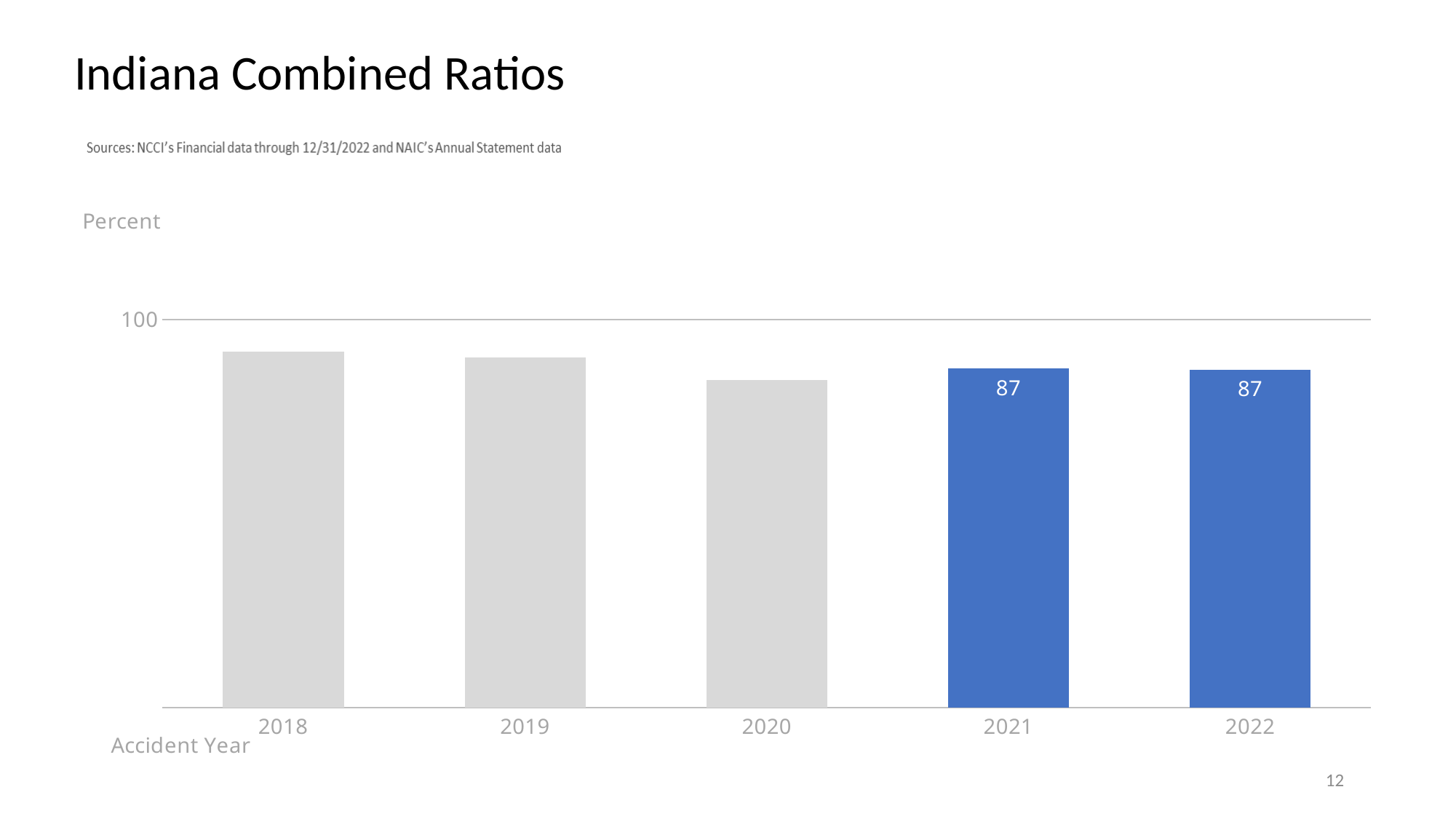
What is the combined ratio for accident year 2021? 87 What is the difference between the values for 2021 and 2022? 0 Which accident year has the lowest combined ratio? 2020 What kind of chart is shown on the slide? Bar chart Which is larger, the value for 2018 or the value for 2020? 2018 Are the values for 2021 and 2022 the same? Yes Do the values rise or fall from 2018 to 2020? Fall What is the label of the horizontal axis? Accident Year Is the value for 2020 greater or less than 100? less How many accident years are shown in the chart? 5 What is the combined ratio for accident year 2022? 87 Is the value for 2018 greater or less than 100? less